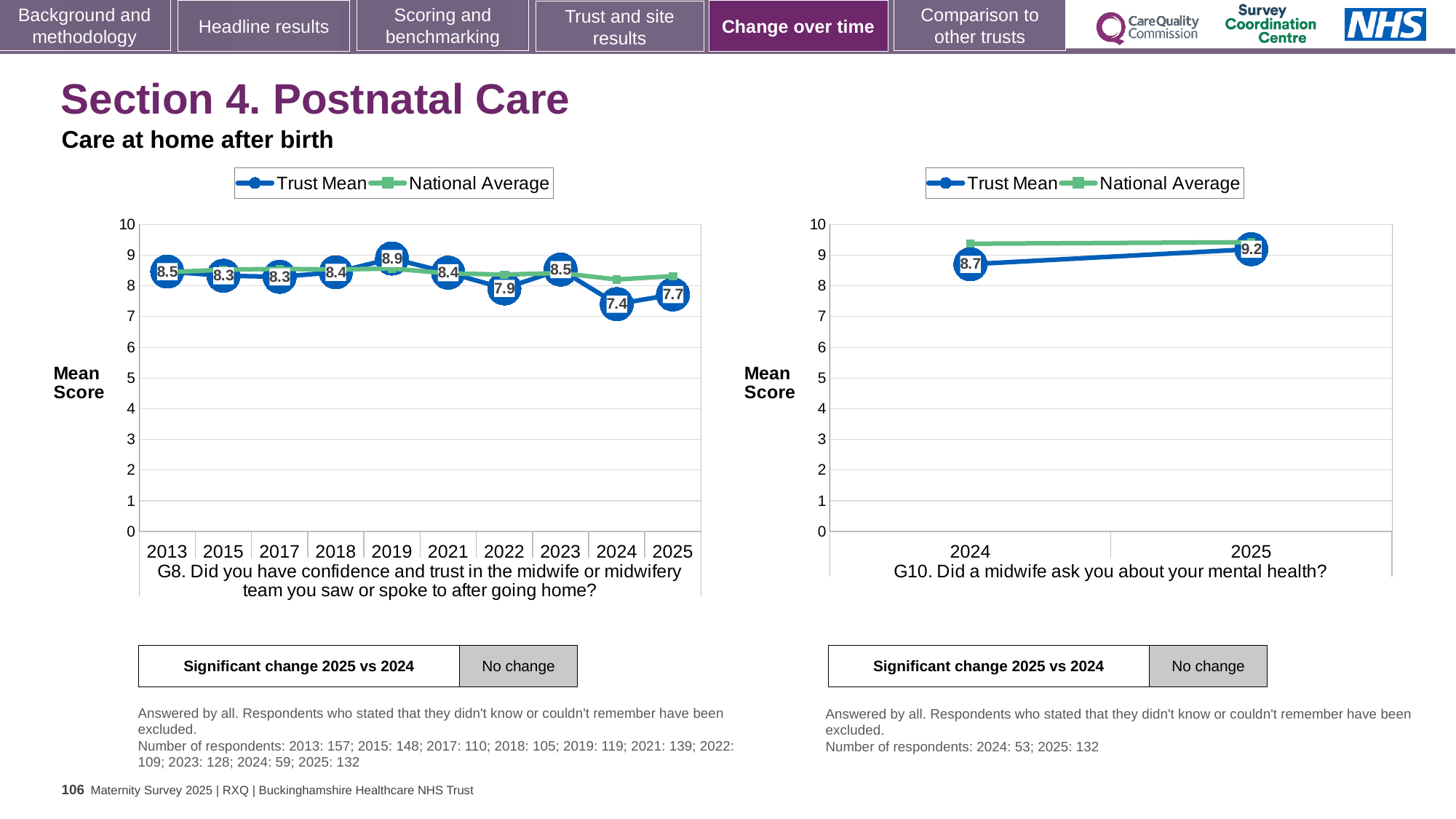
In the G10 chart on the right, is the Trust Mean for 2025 higher or lower than for 2024? higher In the G8 chart on the left, what is the Trust Mean for 2024? 7.4 In the G10 chart on the right, is the National Average for 2024 greater or less than 9? greater In the G8 chart on the left, which year has the lowest Trust Mean? 2024 In the G8 chart on the left, what is the difference between the Trust Mean for 2019 and the Trust Mean for 2024? 1.5 In the G10 chart on the right, what is the Trust Mean for 2025? 9.2 In the G8 chart on the left, what is the Trust Mean for 2019? 8.9 In the G10 chart on the right, what is the difference between the Trust Mean for 2025 and 2024? 0.5 What type of chart is the G10 chart on the right? line chart How many series does the legend of the G8 chart on the left list? 2 In the G8 chart on the left, how many years are shown on the x axis? 10 In the G8 chart on the left, which year has the highest Trust Mean? 2019